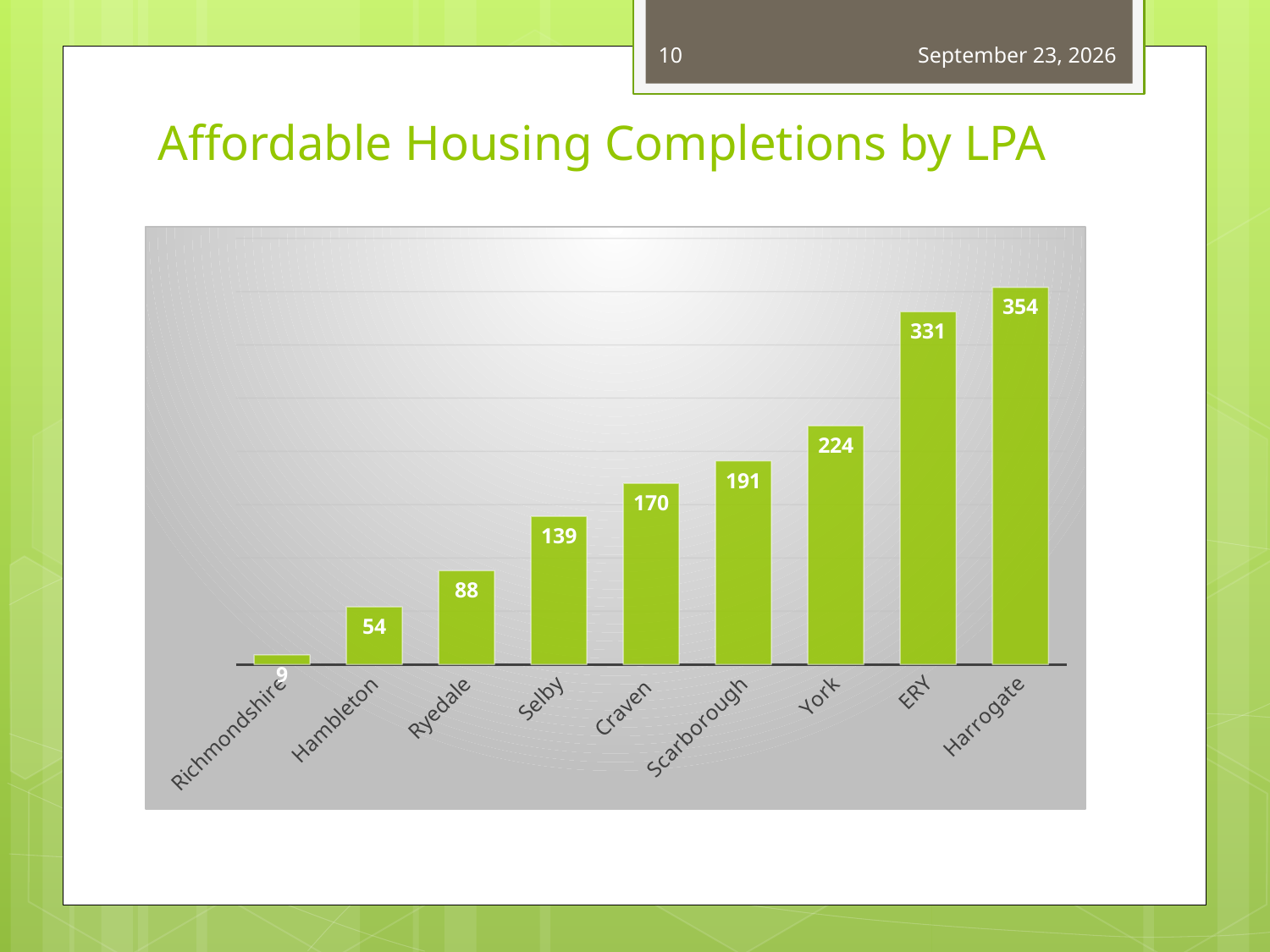
What is the value for Selby? 139 Do the values rise or fall from left to right along the x axis? Rise What is the difference between the values for Harrogate and ERY? 23 What kind of chart is shown on the slide? Bar chart Which LPA has the lowest number of affordable housing completions? Richmondshire How many LPAs are shown on the chart? 9 What is the value for York? 224 What is the difference between the values for Scarborough and Craven? 21 What is the value for Richmondshire? 9 Which LPA has the highest number of affordable housing completions? Harrogate Which is larger, the value for Ryedale or the value for Hambleton? Ryedale What is the title of the slide? Affordable Housing Completions by LPA